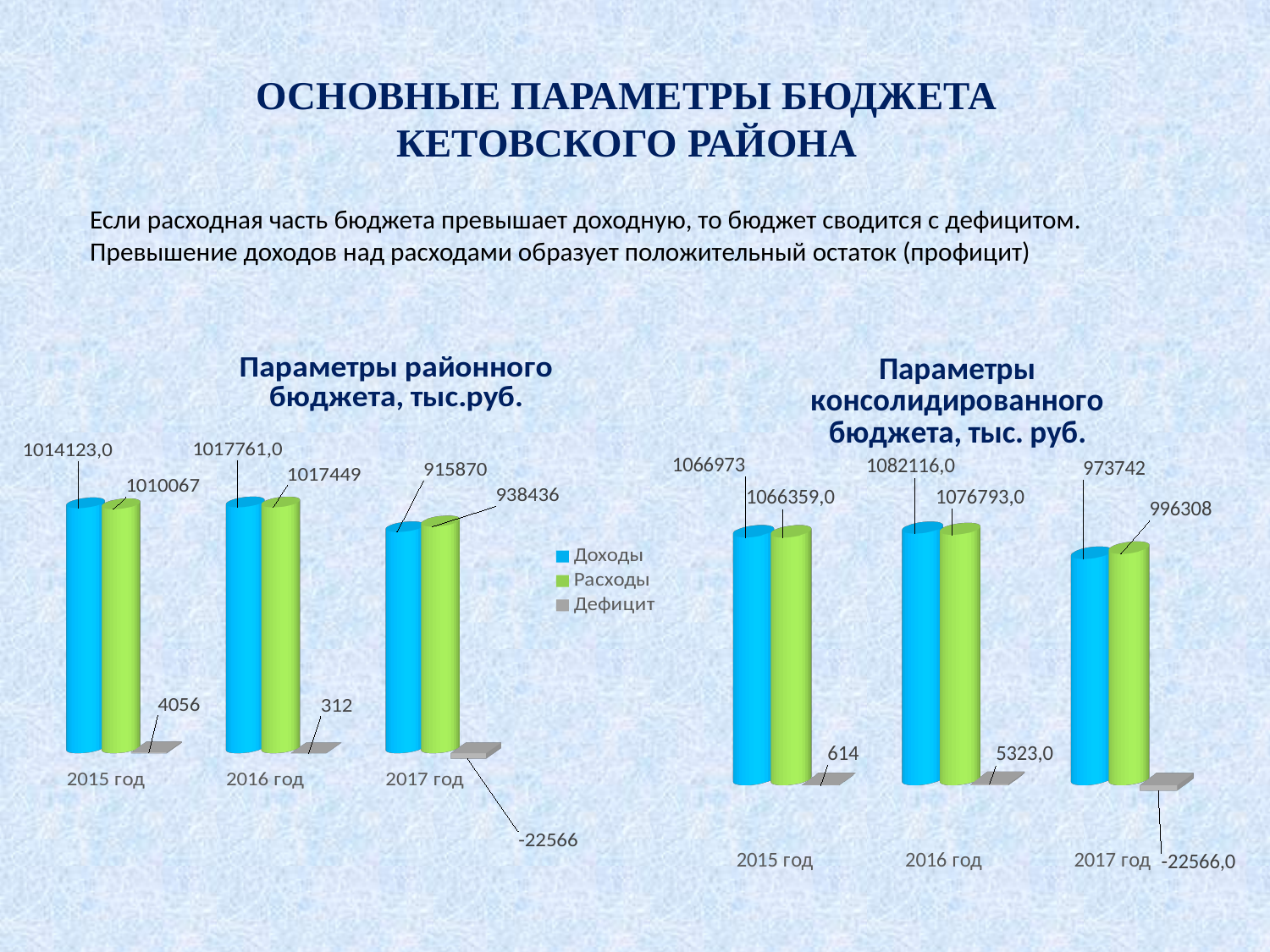
How many years are shown on the x axis of the chart 'Параметры районного бюджета, тыс.руб.'? 3 In the chart 'Параметры консолидированного бюджета, тыс. руб.', what is the value of Доходы for 2016 год? 1082116,0 What kind of chart is 'Параметры консолидированного бюджета, тыс. руб.'? Bar chart In the chart 'Параметры консолидированного бюджета, тыс. руб.', what is the difference between Расходы and Доходы for 2017 год? 22566 In the chart 'Параметры районного бюджета, тыс.руб.', what is the value of Расходы for 2017 год? 938436 In the chart 'Параметры районного бюджета, тыс.руб.', which year has the lowest Расходы value? 2017 год How many series does the legend list for the charts on the slide? 3 In the chart 'Параметры районного бюджета, тыс.руб.', what is the value of Доходы for 2015 год? 1014123,0 In the chart 'Параметры районного бюджета, тыс.руб.', what is the value of Дефицит for 2016 год? 312 In the chart 'Параметры консолидированного бюджета, тыс. руб.', what is the value of Дефицит for 2017 год? -22566,0 In the chart 'Параметры районного бюджета, тыс.руб.', which is larger for 2017 год: Доходы or Расходы? Расходы In the chart 'Параметры консолидированного бюджета, тыс. руб.', which year has the highest Доходы value? 2016 год